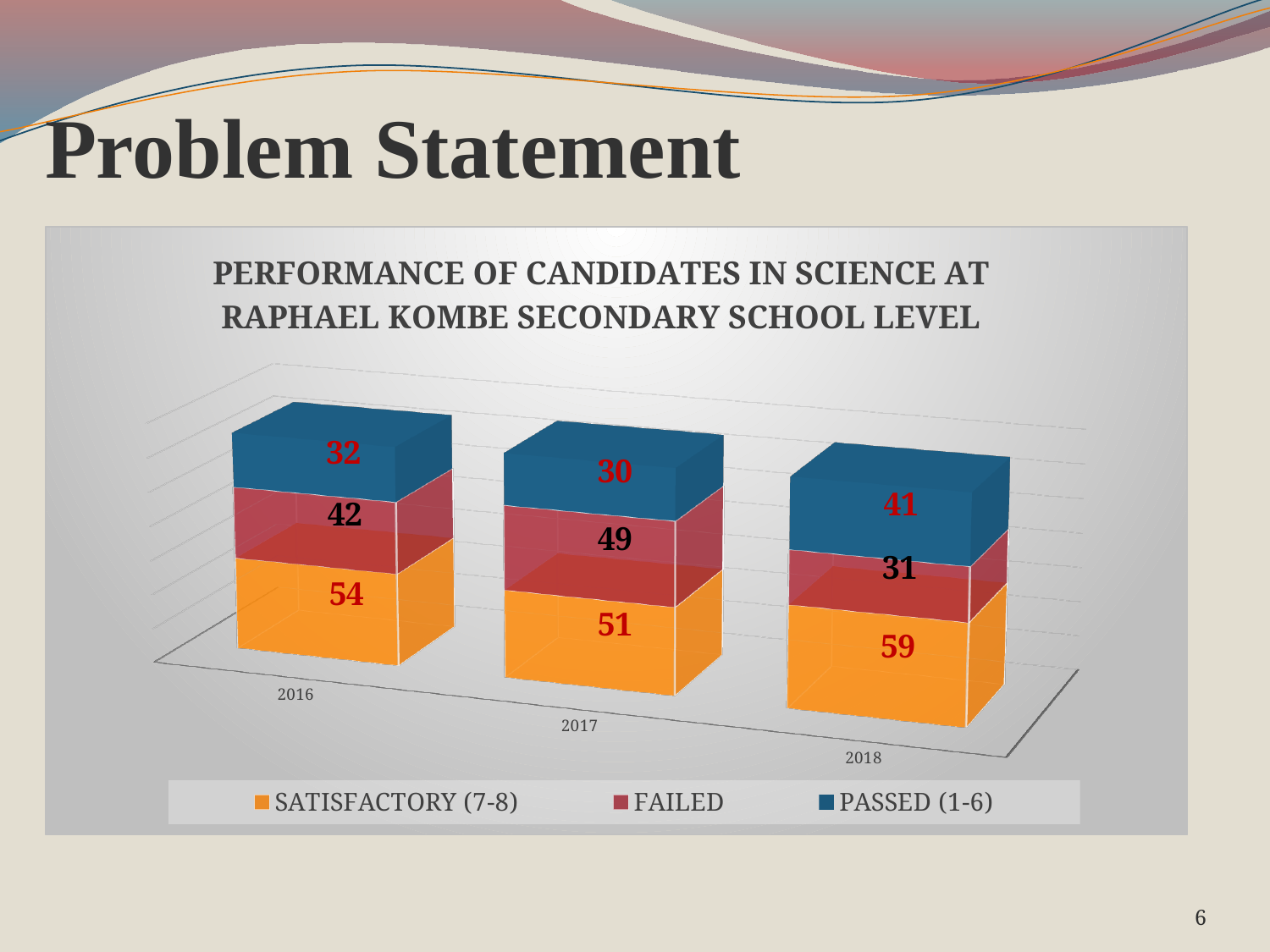
Which series is shown in blue in the legend? PASSED (1-6) How many series does the legend list? 3 What is the difference between the SATISFACTORY (7-8) values for 2018 and 2017? 8 In which year is the FAILED value lowest? 2018 In which year is the PASSED (1-6) value highest? 2018 What is the value for SATISFACTORY (7-8) in 2016? 54 What kind of chart is shown on the slide? Stacked bar chart What is the total of the stacked bar for 2016? 128 What is the value for PASSED (1-6) in 2018? 41 How many years are shown on the x axis? 3 Which is larger, the FAILED value in 2016 or the FAILED value in 2017? 2017 What is the value for FAILED in 2017? 49